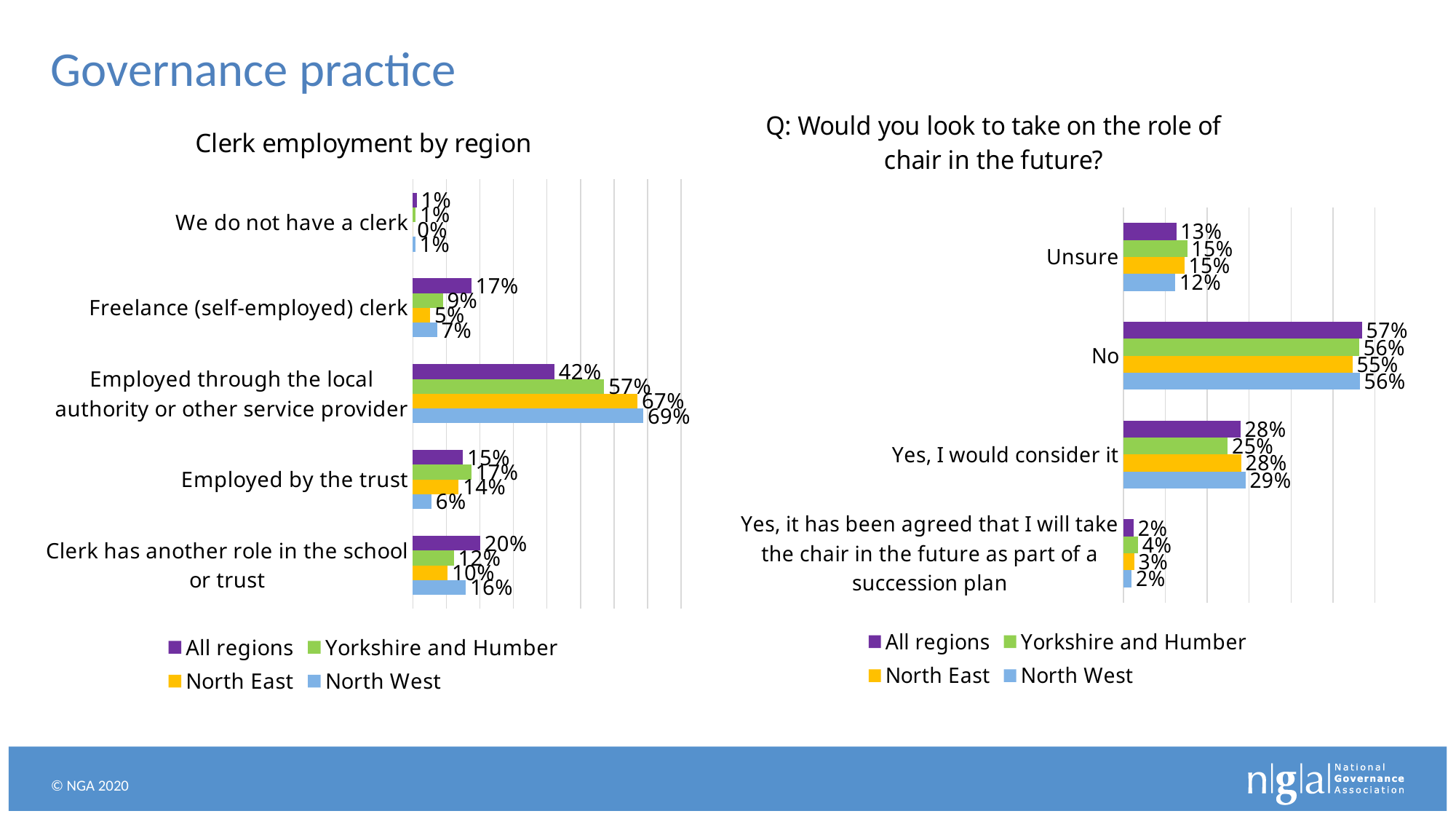
In the 'Clerk employment by region' chart, what is the All regions value for 'Freelance (self-employed) clerk'? 17% In the 'Clerk employment by region' chart, how many categories are shown? 5 In the chart 'Q: Would you look to take on the role of chair in the future?', which region has the highest value for 'Yes, it has been agreed that I will take the chair in the future as part of a succession plan'? Yorkshire and Humber What type of chart is 'Clerk employment by region'? Bar chart In the 'Clerk employment by region' chart, what is the difference between the North East and All regions values for 'Employed through the local authority or other service provider'? 25% In the chart 'Q: Would you look to take on the role of chair in the future?', what is the North West value for 'Yes, I would consider it'? 29% In the chart 'Q: Would you look to take on the role of chair in the future?', what is the All regions value for 'No'? 57% In the 'Clerk employment by region' chart, what is the North West value for 'Employed through the local authority or other service provider'? 69% In the chart 'Q: Would you look to take on the role of chair in the future?', is the Yorkshire and Humber value for 'Unsure' larger or smaller than the North West value for 'Unsure'? larger How many series does the legend of the chart 'Q: Would you look to take on the role of chair in the future?' list? 4 In the 'Clerk employment by region' chart, which region has the lowest value for 'Employed by the trust'? North West In the 'Clerk employment by region' chart, which region has the highest value for 'Employed through the local authority or other service provider'? North West